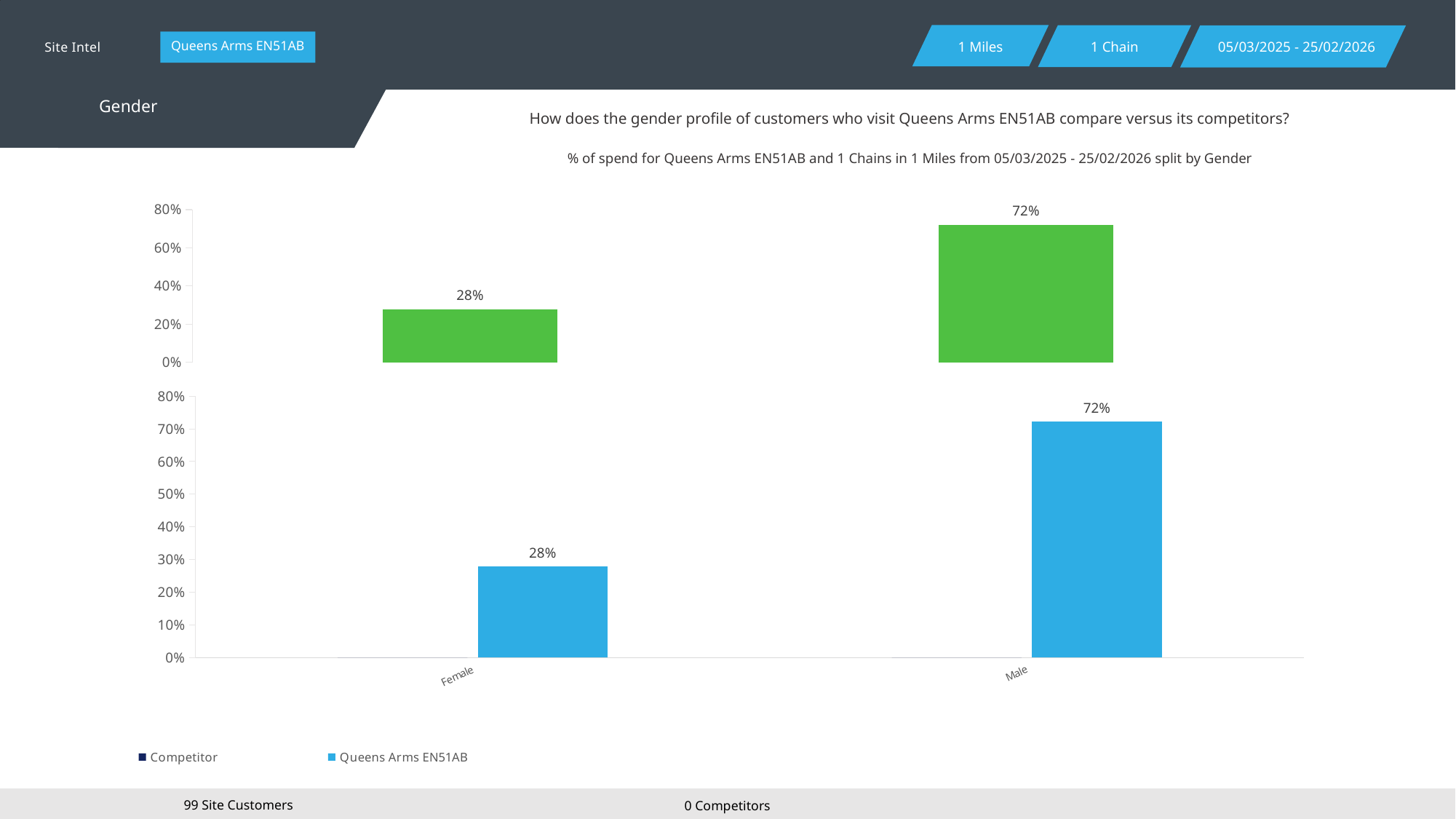
In the top chart, what is the value shown on the left-hand bar? 28% In the bottom chart, which category has the highest value? Male In the bottom chart, what is the value for Male? 72% In the bottom chart, is the value for Female greater or less than 30%? less In the top chart, what is the value shown on the right-hand bar? 72% In the bottom chart, what is the value for Female? 28% In the bottom chart, what is the difference between the Male and Female values? 44% How many series does the legend at the bottom of the slide list? 2 What kind of chart is the bottom chart? Bar chart How many categories are shown on the x axis of the bottom chart? 2 In the bottom chart, which category has the lowest value? Female In the bottom chart, is the value for Male greater or less than 50%? greater